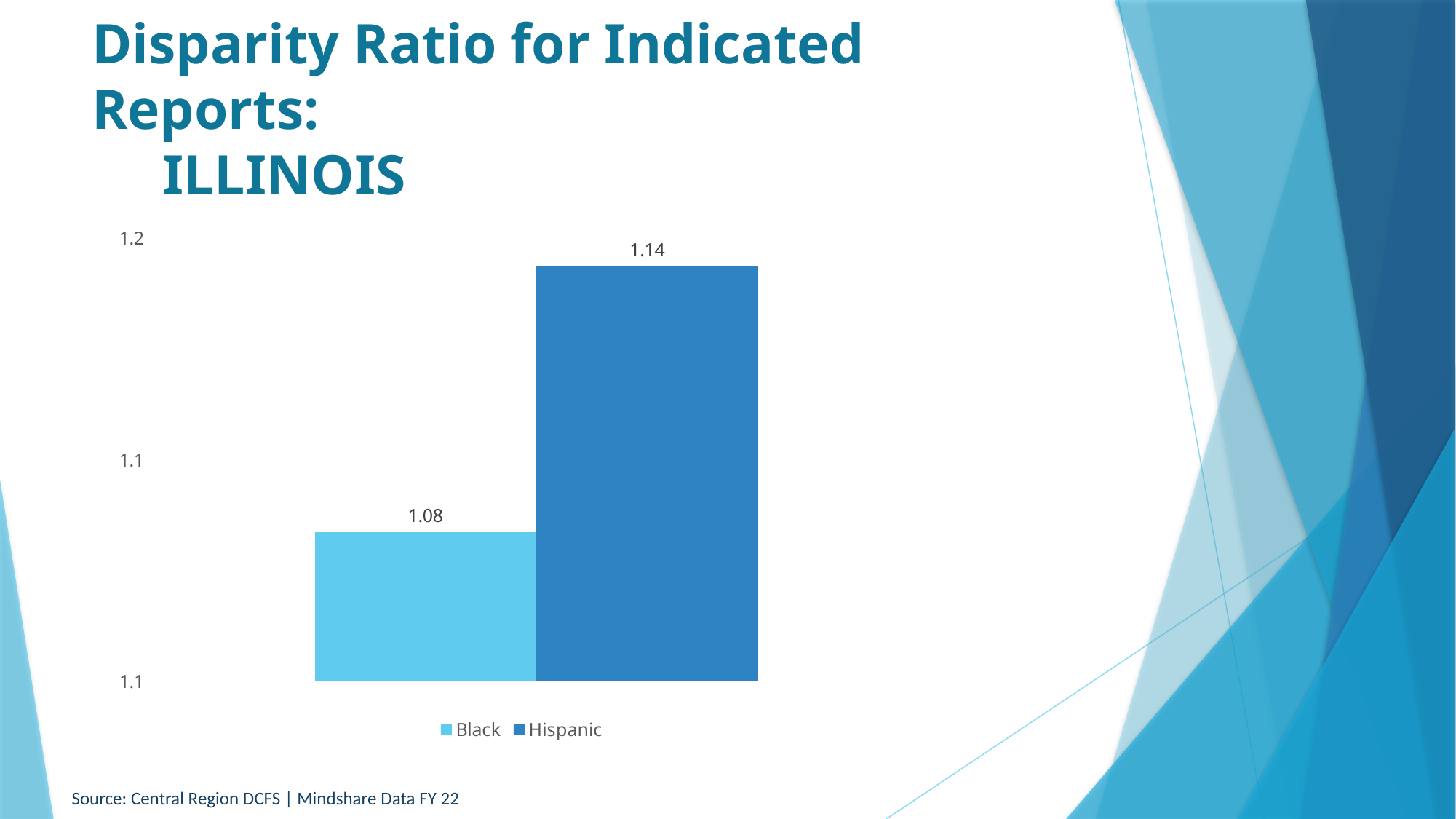
What is the difference between the Hispanic and Black disparity ratios? 0.06 What is the disparity ratio for Black? 1.08 What is the title of the slide? Disparity Ratio for Indicated Reports: ILLINOIS Is the disparity ratio for Black larger or smaller than the ratio for Hispanic? smaller How many bars are plotted in the chart? 2 Which group has the lower disparity ratio? Black Is the value for Hispanic greater or less than 1.1? greater Is the value for Black greater or less than 1.1? less What kind of chart is shown on the slide? bar chart What is the disparity ratio for Hispanic? 1.14 Which group has the higher disparity ratio? Hispanic How many entries does the legend list? 2